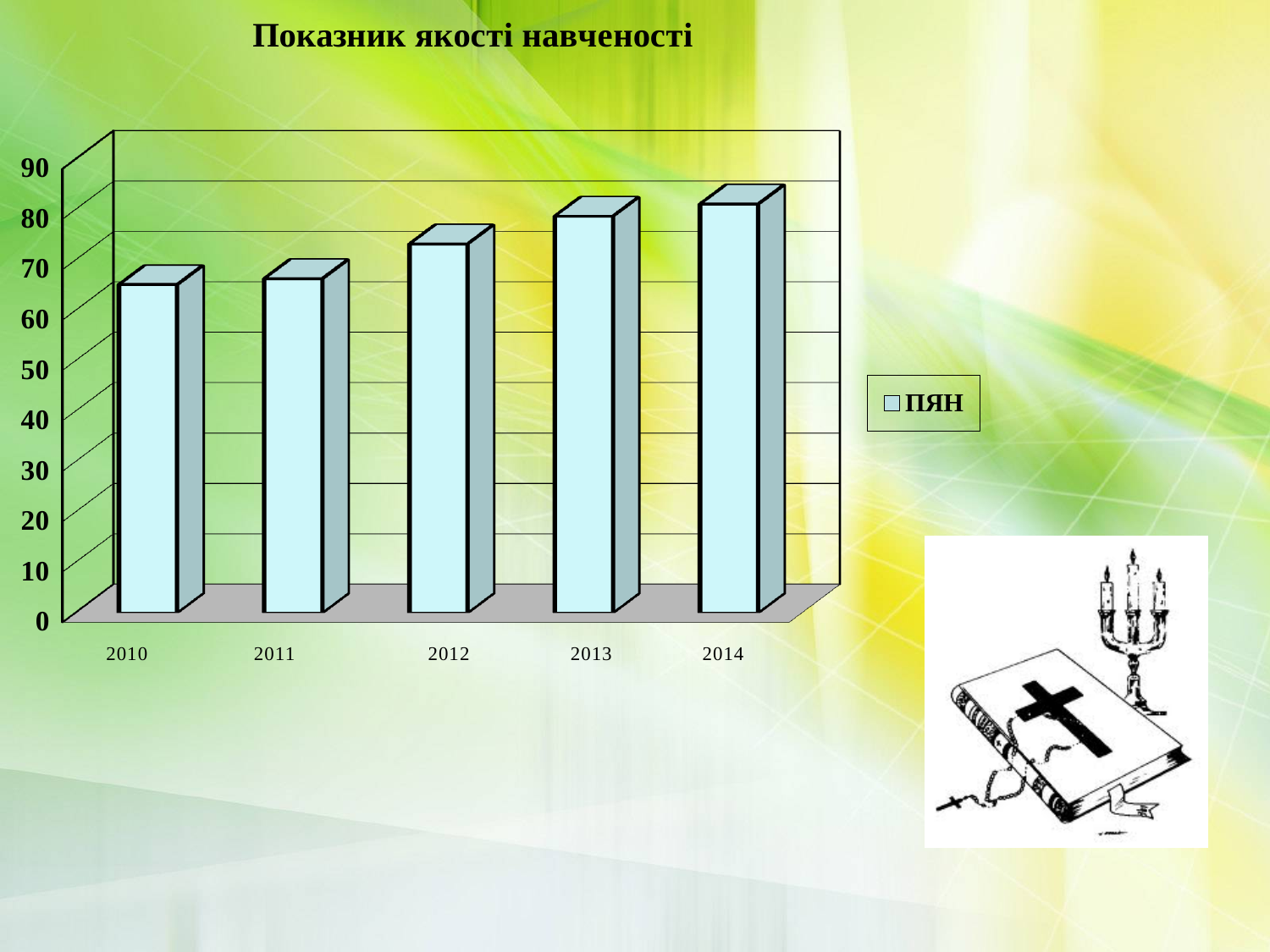
How many years are shown on the x axis of the chart? 5 What is the name of the series shown in the legend? ПЯН What kind of chart is shown on the slide? bar chart Which year has the highest value in the chart? 2014 Do the values rise or fall from 2010 to 2014? rise How many series does the legend list? 1 Is the value for 2011 greater or less than 60? greater Is the value for 2014 greater or less than 70? greater Which is larger, the value for 2012 or the value for 2010? 2012 Is the value for 2012 greater or less than 80? less What is the title of the chart? Показник якості навченості